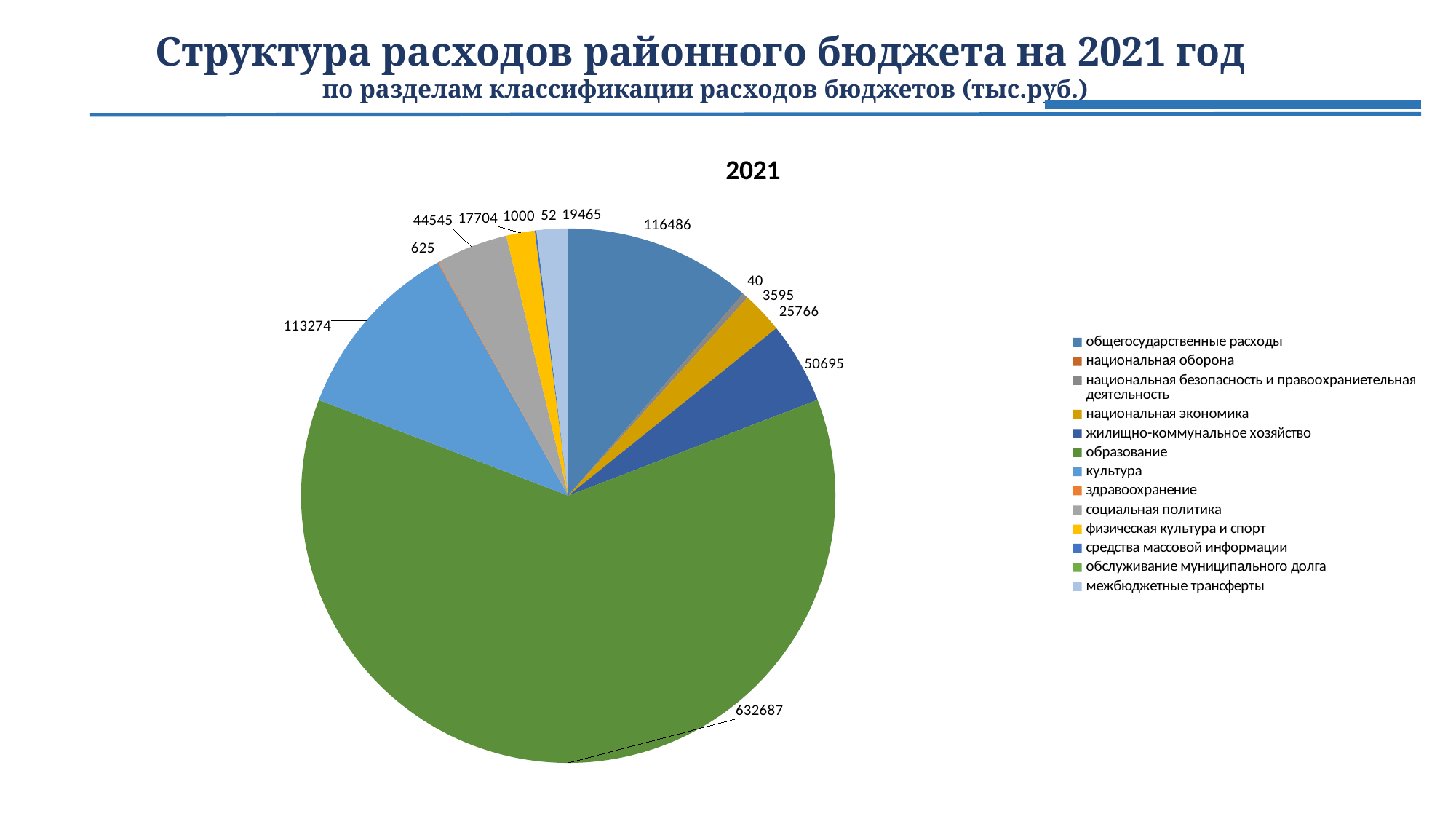
What is the title shown above the pie chart? 2021 How many categories does the pie chart have? 13 Which category has the largest slice of the pie? образование What kind of chart is shown on the slide? pie chart What is the value for межбюджетные трансферты? 19465 Which is larger: социальная политика or национальная экономика? социальная политика What is the value for жилищно-коммунальное хозяйство? 50695 What is the value for культура? 113274 What is the value for общегосударственные расходы? 116486 What is the difference between the values for общегосударственные расходы and культура? 3212 What is the value for образование? 632687 Which category has the smallest value? национальная оборона